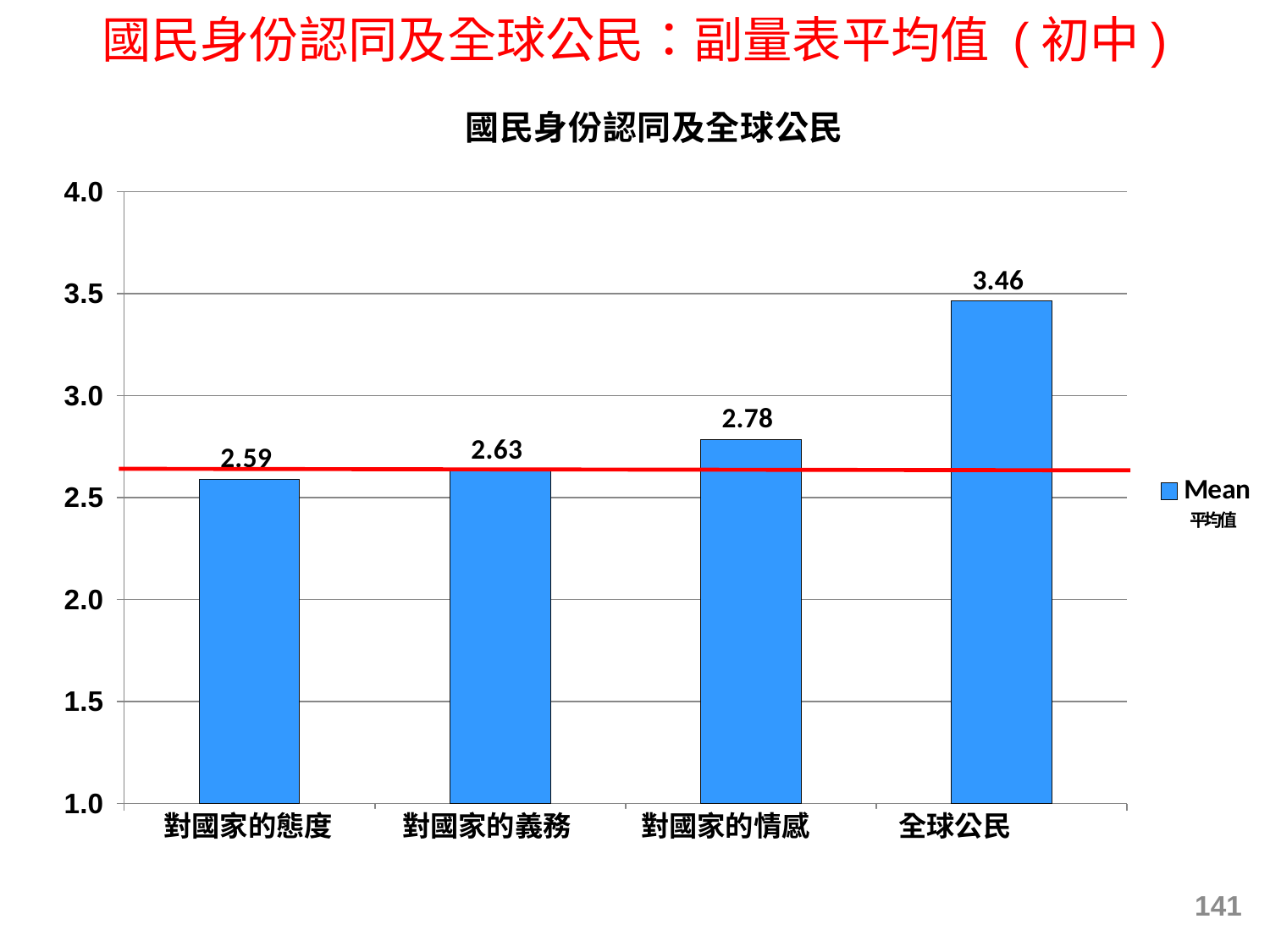
How many series does the legend list? 1 What kind of chart is shown? bar chart What is the value for 全球公民? 3.46 How many categories are shown on the x axis? 4 Which category has the highest value? 全球公民 What is the difference between the values for 全球公民 and 對國家的義務? 0.83 What is the value for 對國家的情感? 2.78 What is the title of the chart? 國民身份認同及全球公民 Which is larger, the value for 對國家的情感 or the value for 對國家的義務? 對國家的情感 What is the value for 對國家的態度? 2.59 Is the value for 全球公民 greater or less than 3.0? greater Which category has the lowest value? 對國家的態度